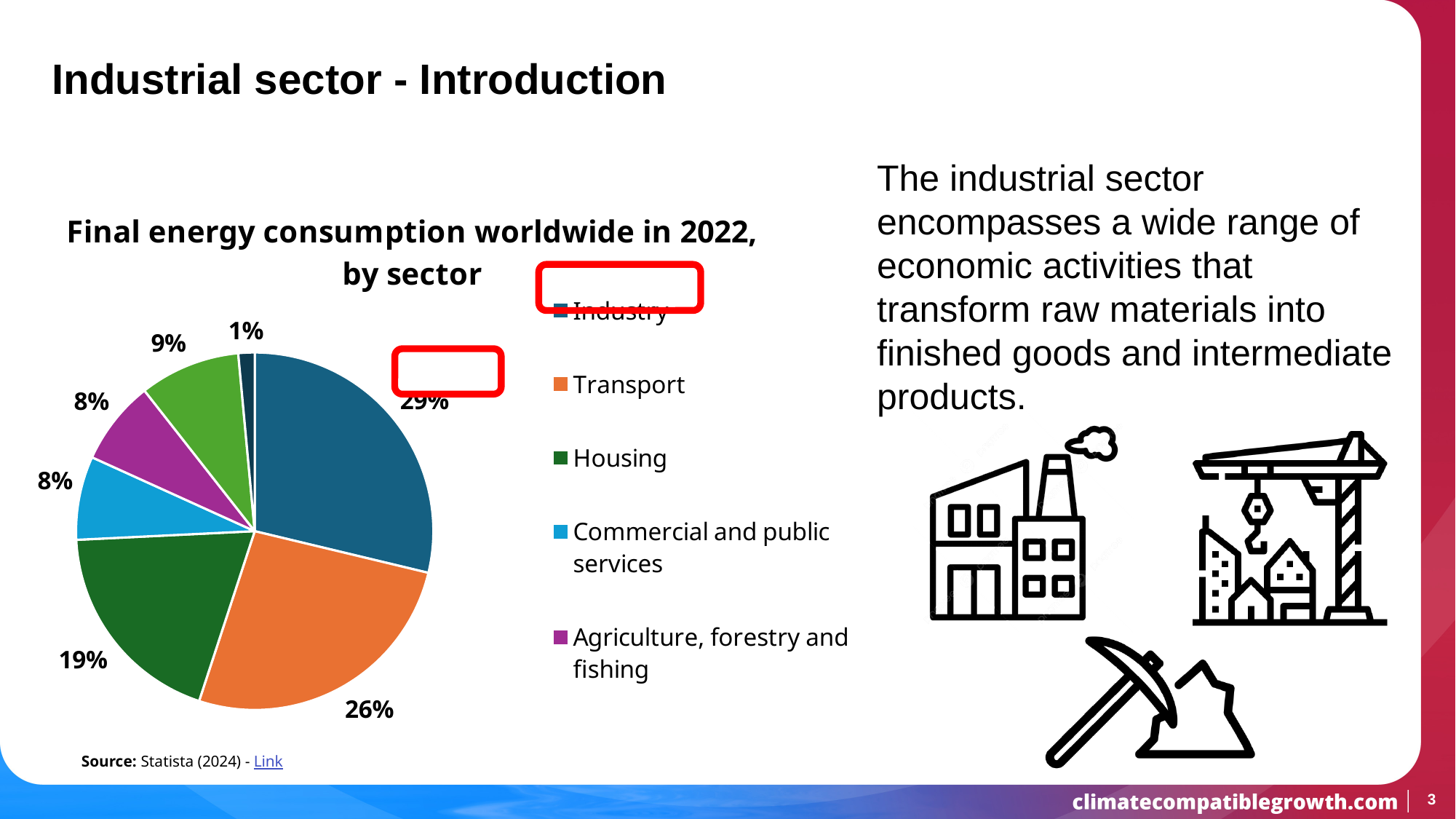
What share of final energy consumption does Transport account for? 26% What share of final energy consumption does Industry account for? 29% What share of final energy consumption does Agriculture, forestry and fishing account for? 8% How many slices does the pie chart have? 7 What is the title of the chart? Final energy consumption worldwide in 2022, by sector What kind of chart is shown on the slide? pie chart What share of final energy consumption do Commercial and public services account for? 8% How many percentage points larger is the Industry share than the Transport share? 3 percentage points Which sector has the largest share of final energy consumption in the pie chart? Industry Which has a larger share of final energy consumption, Transport or Housing? Transport What share of final energy consumption does Housing account for? 19% What is the smallest percentage shown on the pie chart? 1%